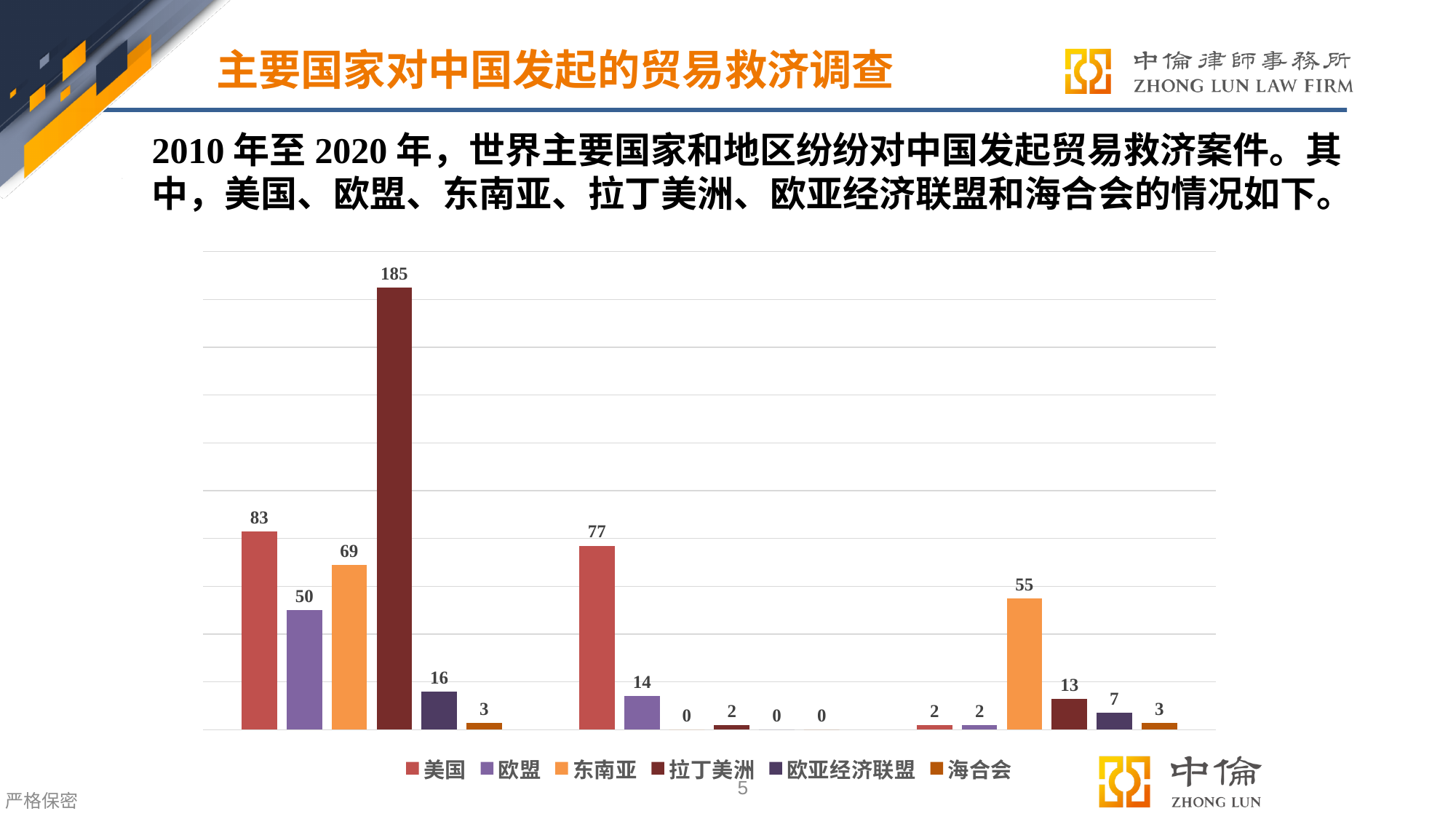
Which series has the highest value in the first (leftmost) group of bars? 拉丁美洲 Which series has the highest value in the second (middle) group of bars? 美国 In the first (leftmost) group of bars, what is the difference between the values for 拉丁美洲 and 美国? 102 How many series does the legend list? 6 Which series is shown in orange in the legend? 东南亚 In the third (rightmost) group of bars, what is the value for 东南亚? 55 In the second (middle) group of bars, what is the value for 欧盟? 14 In the third (rightmost) group of bars, which is larger, the value for 东南亚 or the value for 拉丁美洲? 东南亚 In the first (leftmost) group of bars, what is the value for 拉丁美洲? 185 In the first (leftmost) group of bars, what is the value for 美国? 83 What kind of chart is shown on the slide? bar chart How many groups of bars are plotted along the x axis? 3